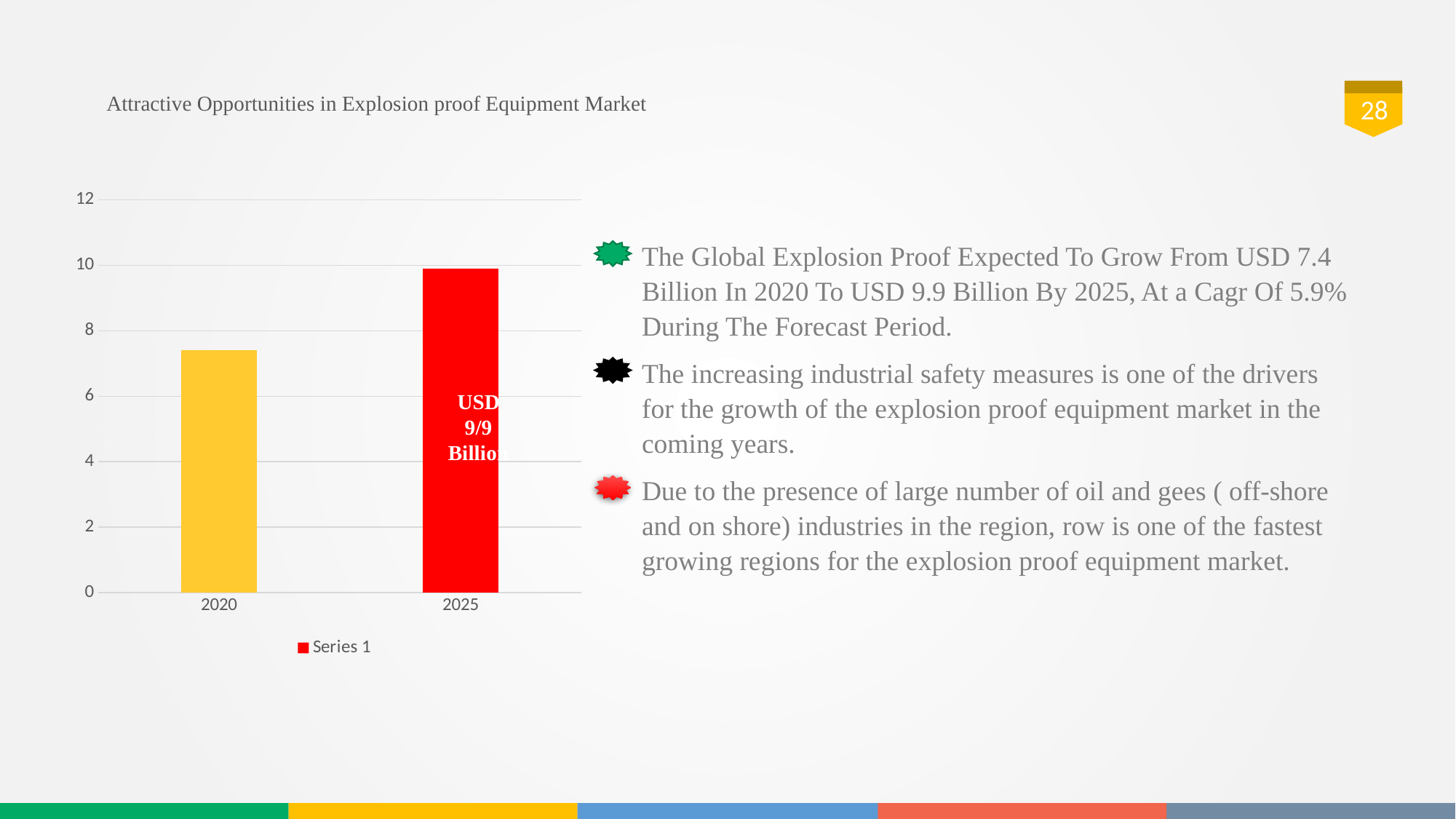
Which year has the lowest bar in the chart? 2020 Is the value for 2025 greater or less than 8? greater What colour is the bar for 2020? yellow How many categories are plotted on the x axis of the chart? 2 Is the value for 2020 greater or less than 6? greater What is the name of the series listed in the chart legend? Series 1 How many series does the chart legend list? 1 Is the value for 2020 greater or less than 8? less Which year has the highest bar in the chart? 2025 Do the values rise or fall from 2020 to 2025? rise What kind of chart is shown on the slide? bar chart Which bar is taller, 2020 or 2025? 2025